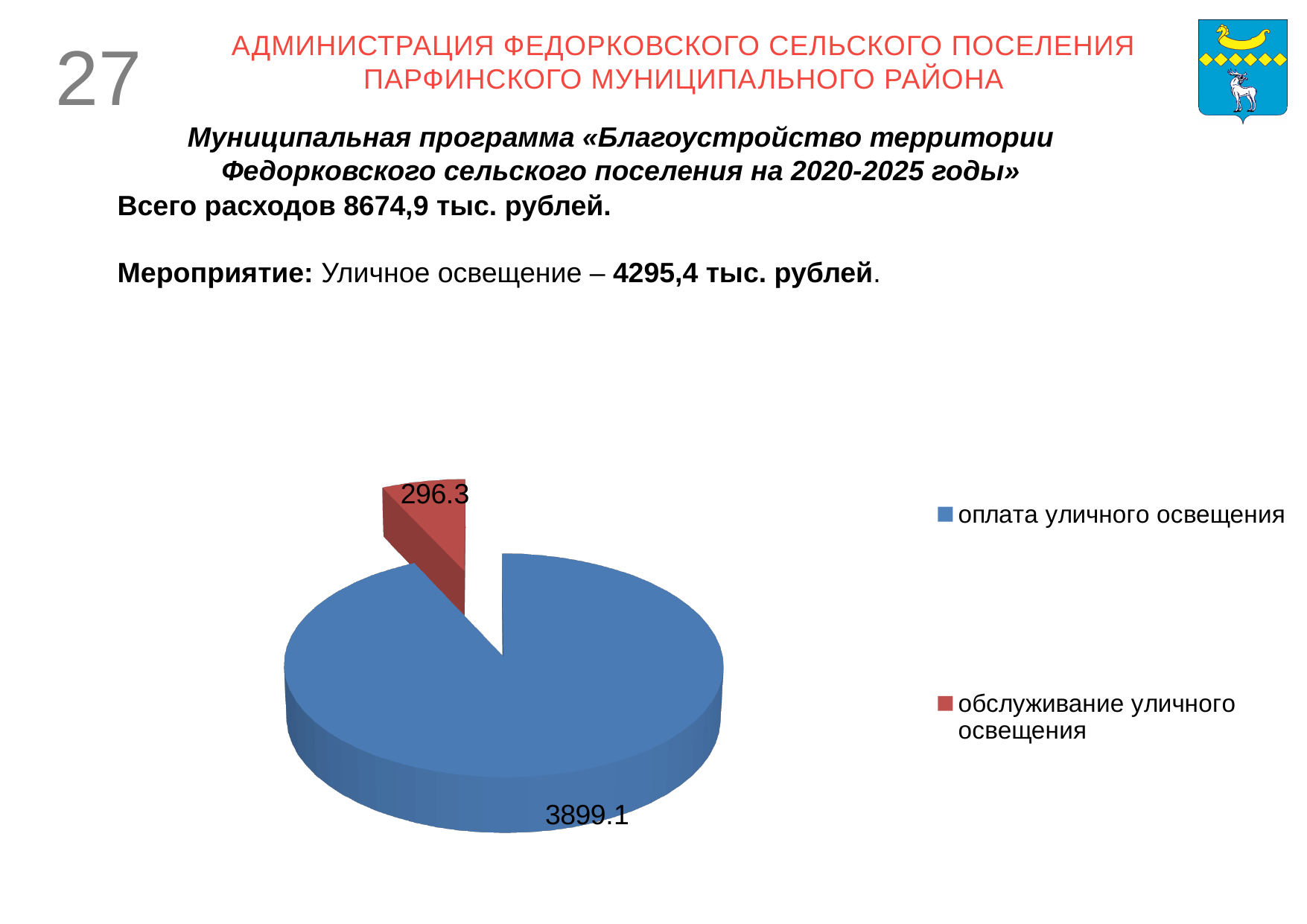
Which category has the smallest slice of the pie? обслуживание уличного освещения What is the value for оплата уличного освещения? 3899.1 How many slices does the pie chart have? 2 What is the difference between the values for оплата уличного освещения and обслуживание уличного освещения? 3602.8 What is the value for обслуживание уличного освещения? 296.3 How many entries does the legend list? 2 What is the total of the two values shown in the pie chart? 4195.4 Which category has the largest slice of the pie? оплата уличного освещения What colour is the slice for обслуживание уличного освещения? red What colour is the slice for оплата уличного освещения? blue What type of chart is shown on the slide? pie chart Which is larger: оплата уличного освещения or обслуживание уличного освещения? оплата уличного освещения